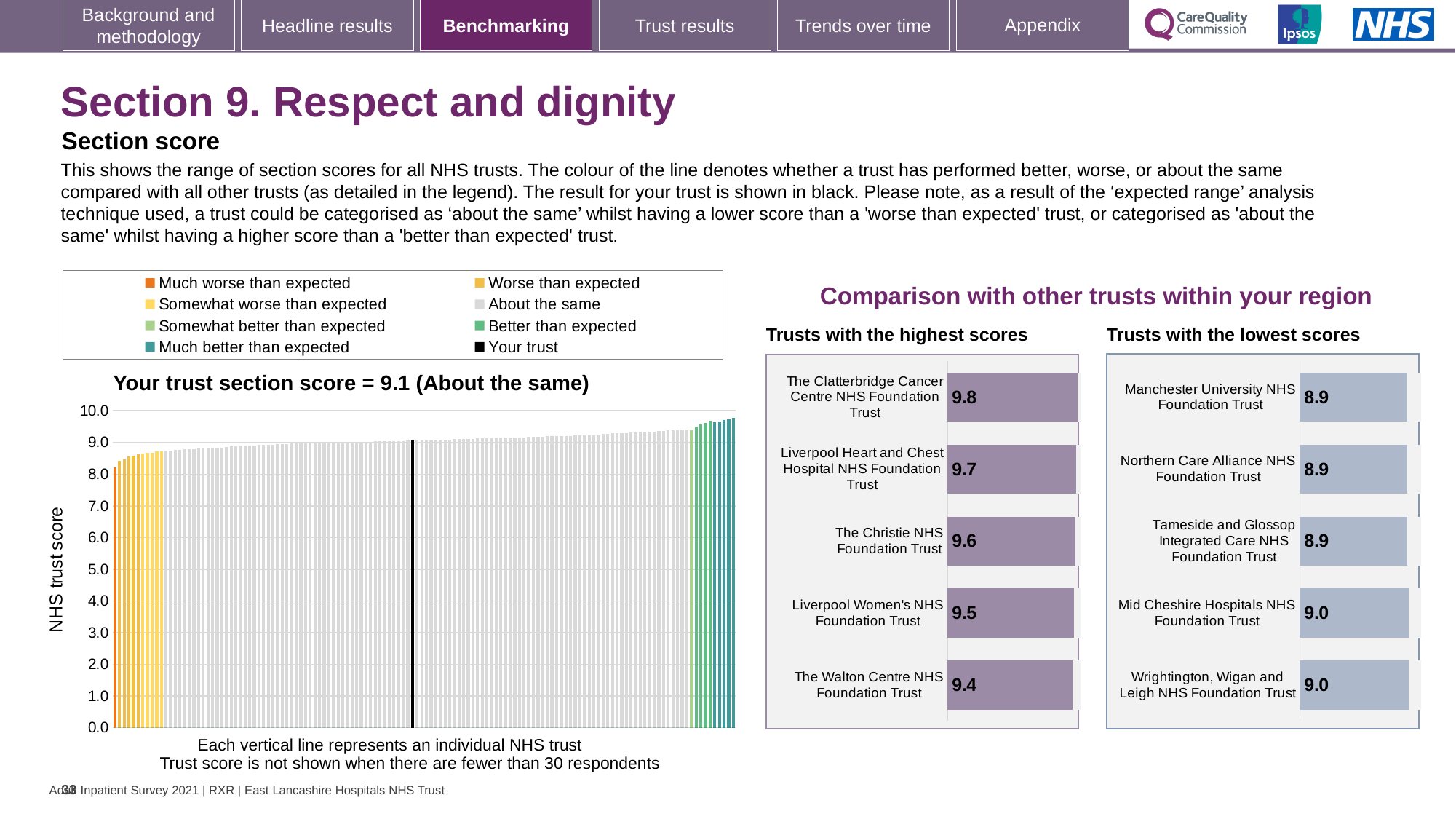
How many entries does the legend above the 'Your trust section score' chart list? 8 How many trusts are shown on the 'Trusts with the lowest scores' chart? 5 On the 'Trusts with the lowest scores' chart, what is the score for Mid Cheshire Hospitals NHS Foundation Trust? 9.0 Which is larger: the score for The Christie NHS Foundation Trust on the 'Trusts with the highest scores' chart or the score for Manchester University NHS Foundation Trust on the 'Trusts with the lowest scores' chart? The Christie NHS Foundation Trust What is the y-axis label on the 'Your trust section score' chart? NHS trust score On the 'Your trust section score' chart, what is the section score for your trust? 9.1 On the 'Your trust section score' chart, do the trust scores rise or fall from left to right along the x axis? rise On the 'Trusts with the highest scores' chart, which trust has the highest score? The Clatterbridge Cancer Centre NHS Foundation Trust On the 'Your trust section score' chart, is the value of the leftmost bar greater or less than 9.0? less On the 'Trusts with the highest scores' chart, what is the difference between the scores of The Clatterbridge Cancer Centre NHS Foundation Trust and The Walton Centre NHS Foundation Trust? 0.4 What kind of chart is the 'Your trust section score' chart? bar chart On the 'Trusts with the highest scores' chart, what is the score for The Christie NHS Foundation Trust? 9.6